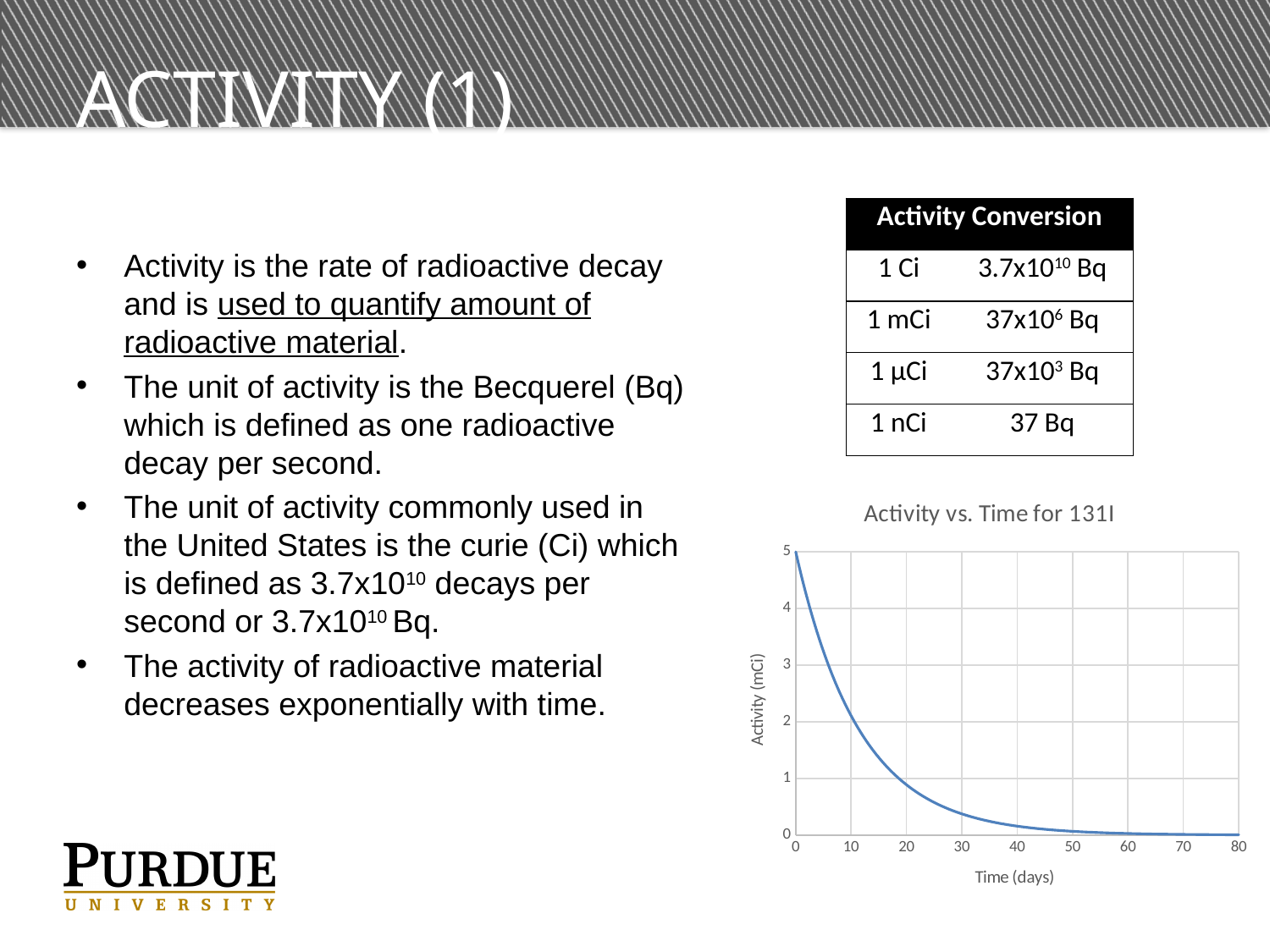
What is the activity in mCi at time 0 days? 5 What is the title of the chart? Activity vs. Time for 131I Is the activity at 5 days greater or less than 1 mCi? greater Does the activity rise or fall as time increases along the x axis? fall Which is larger, the activity at 20 days or the activity at 60 days? 20 days Is the activity at 20 days greater or less than 2 mCi? less What kind of chart is shown on the slide? line chart At which time on the x axis is the activity highest? 0 days Which is larger, the activity at 10 days or the activity at 30 days? 10 days Is the activity at 40 days greater or less than 1 mCi? less What is the label of the vertical axis of the chart? Activity (mCi)